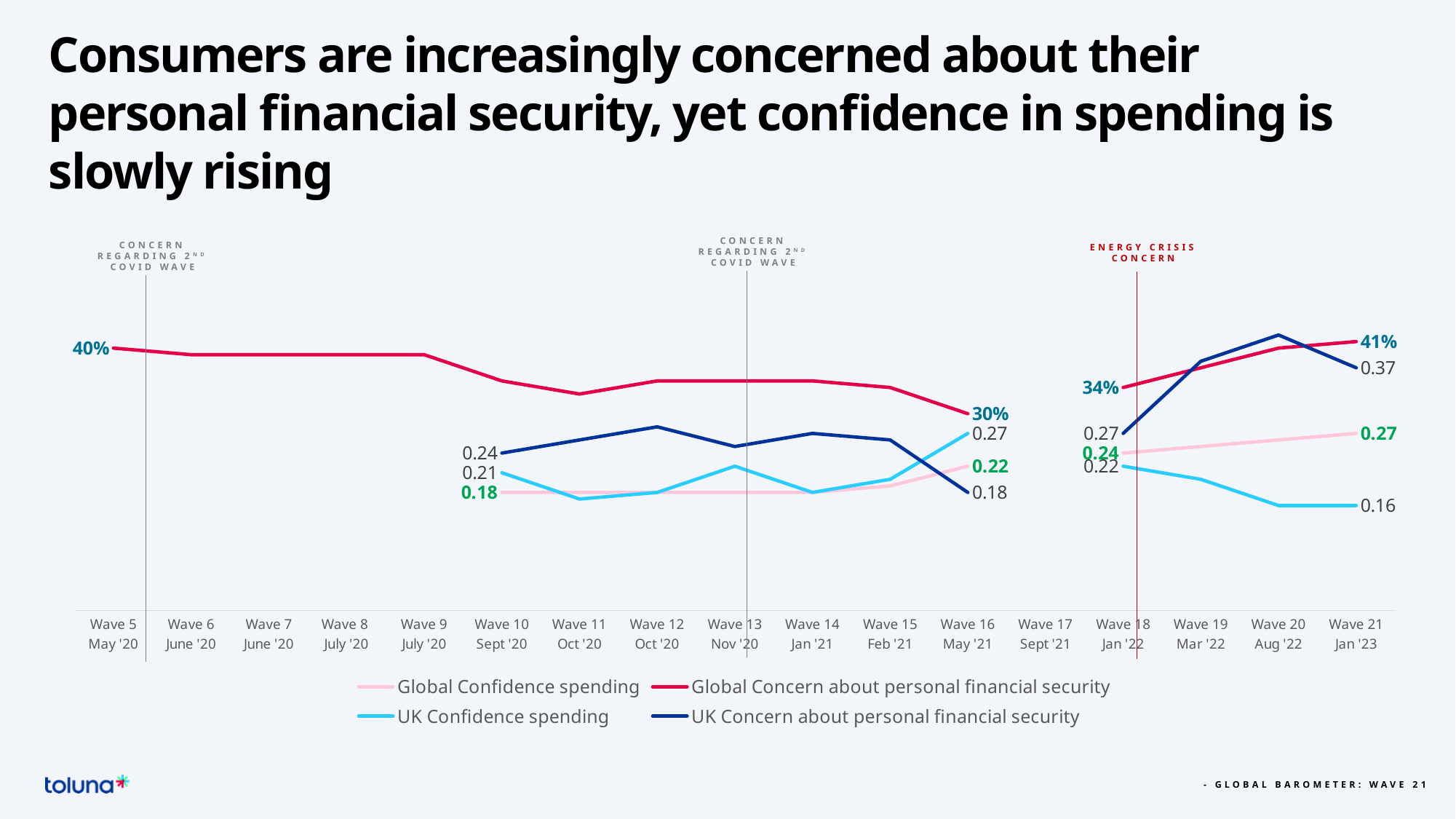
How many series does the legend list? 4 What is the value of Global Concern about personal financial security at Wave 5 (May '20)? 40% What is the value of Global Concern about personal financial security at Wave 21 (Jan '23)? 41% What is the value of Global Confidence spending at Wave 10 (Sept '20)? 0.18 What is the difference between UK Concern about personal financial security at Wave 21 (0.37) and at Wave 18 (0.27)? 0.10 What kind of chart is shown on the slide? Line chart At Wave 16 (May '21), which is higher: UK Confidence spending or Global Confidence spending? UK Confidence spending By how many percentage points did Global Concern about personal financial security rise from Wave 16 (30%) to Wave 21 (41%)? 11 percentage points What is the value of UK Concern about personal financial security at Wave 16 (May '21)? 0.18 Does Global Confidence spending rise or fall from Wave 10 (Sept '20) to Wave 21 (Jan '23)? Rise What is the value of UK Confidence spending at Wave 21 (Jan '23)? 0.16 What is the value of UK Concern about personal financial security at Wave 21 (Jan '23)? 0.37